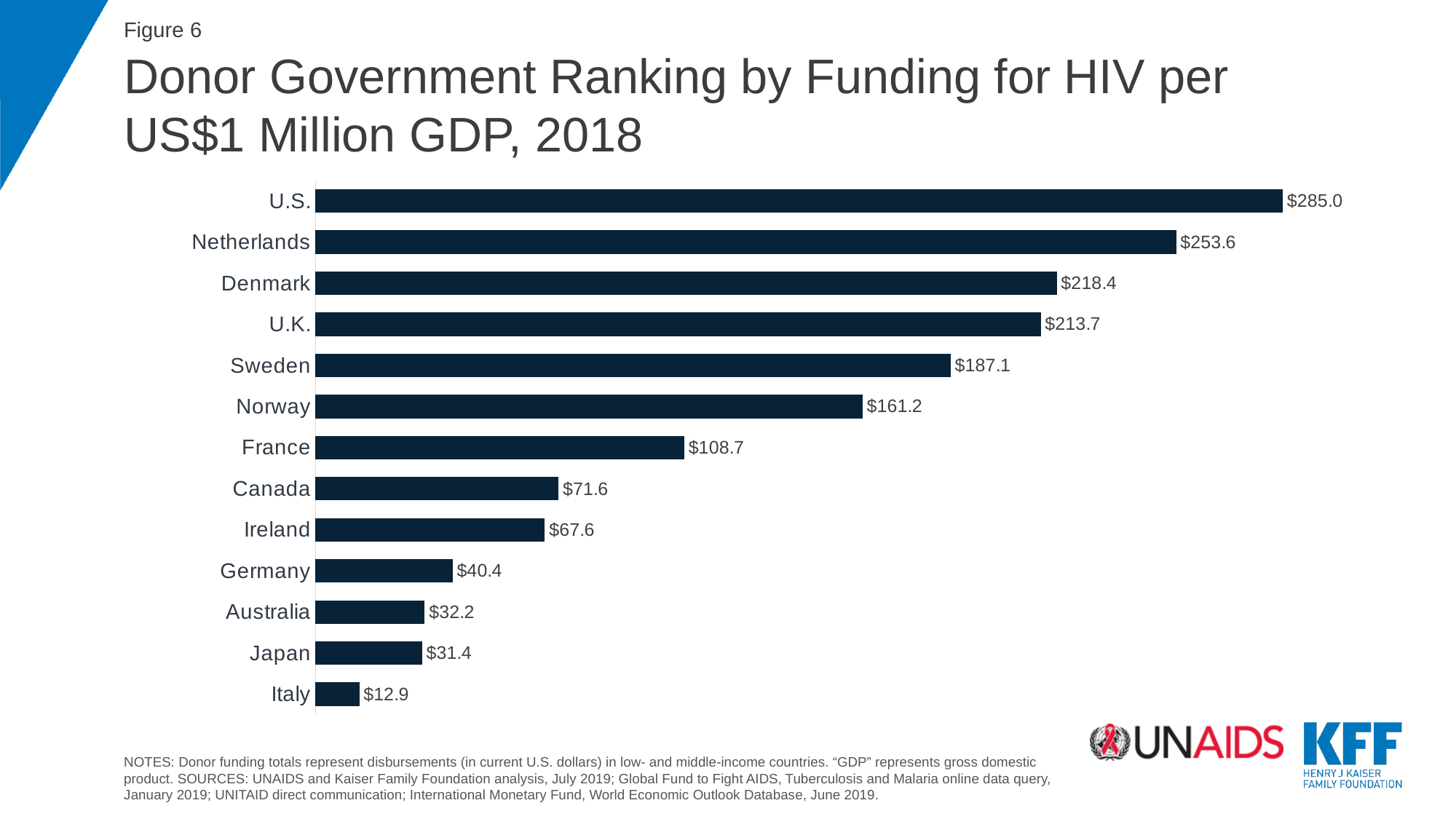
Which has a larger value, Sweden or Norway? Sweden Which country has the lowest funding for HIV per US$1 million GDP? Italy How many countries are shown in the chart? 13 Which country has the highest funding for HIV per US$1 million GDP? U.S. What is the difference between the values for Canada and Ireland? $4.0 What is the difference between the values for the U.S. and the Netherlands? $31.4 Which has a larger value, France or Canada? France What is the value shown for Norway? $161.2 What is the value shown for Germany? $40.4 What is the funding for HIV per US$1 million GDP for the Netherlands? $253.6 What is the title of the chart? Donor Government Ranking by Funding for HIV per US$1 Million GDP, 2018 What kind of chart is shown on the slide? Bar chart